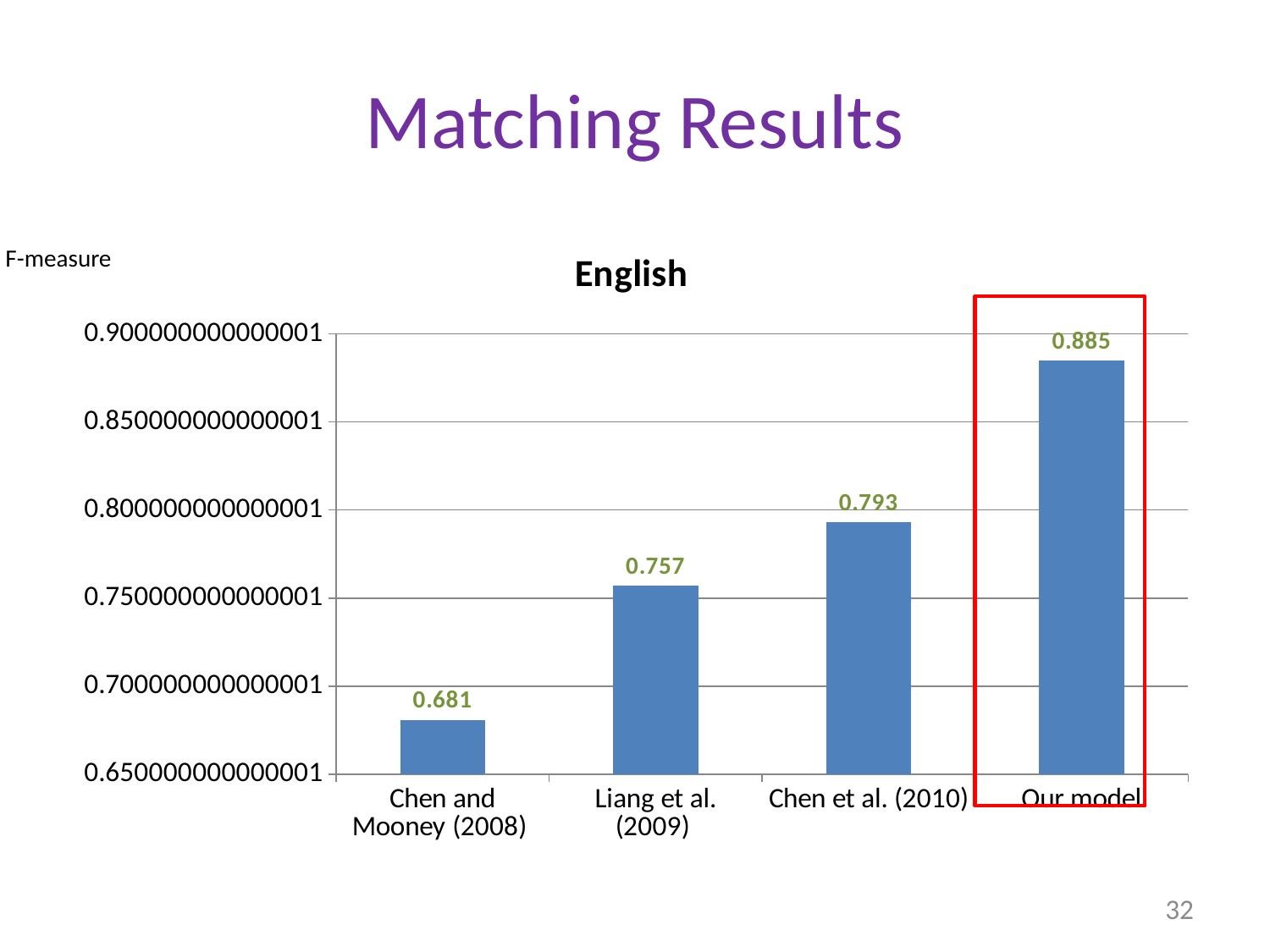
Which has a larger F-measure, Liang et al. (2009) or Chen et al. (2010)? Chen et al. (2010) What is the F-measure value for Chen et al. (2010)? 0.793 What is the F-measure value for Liang et al. (2009)? 0.757 Which category has the highest F-measure? Our model Do the F-measure values rise or fall from left to right across the categories? Rise What kind of chart is shown on the slide? Bar chart What is the F-measure value for Our model? 0.885 What is the F-measure value for Chen and Mooney (2008)? 0.681 What is the title of the chart? English What is the difference between the F-measure of Our model and Chen et al. (2010)? 0.092 Which category has the lowest F-measure? Chen and Mooney (2008) How many categories are shown in the chart? 4